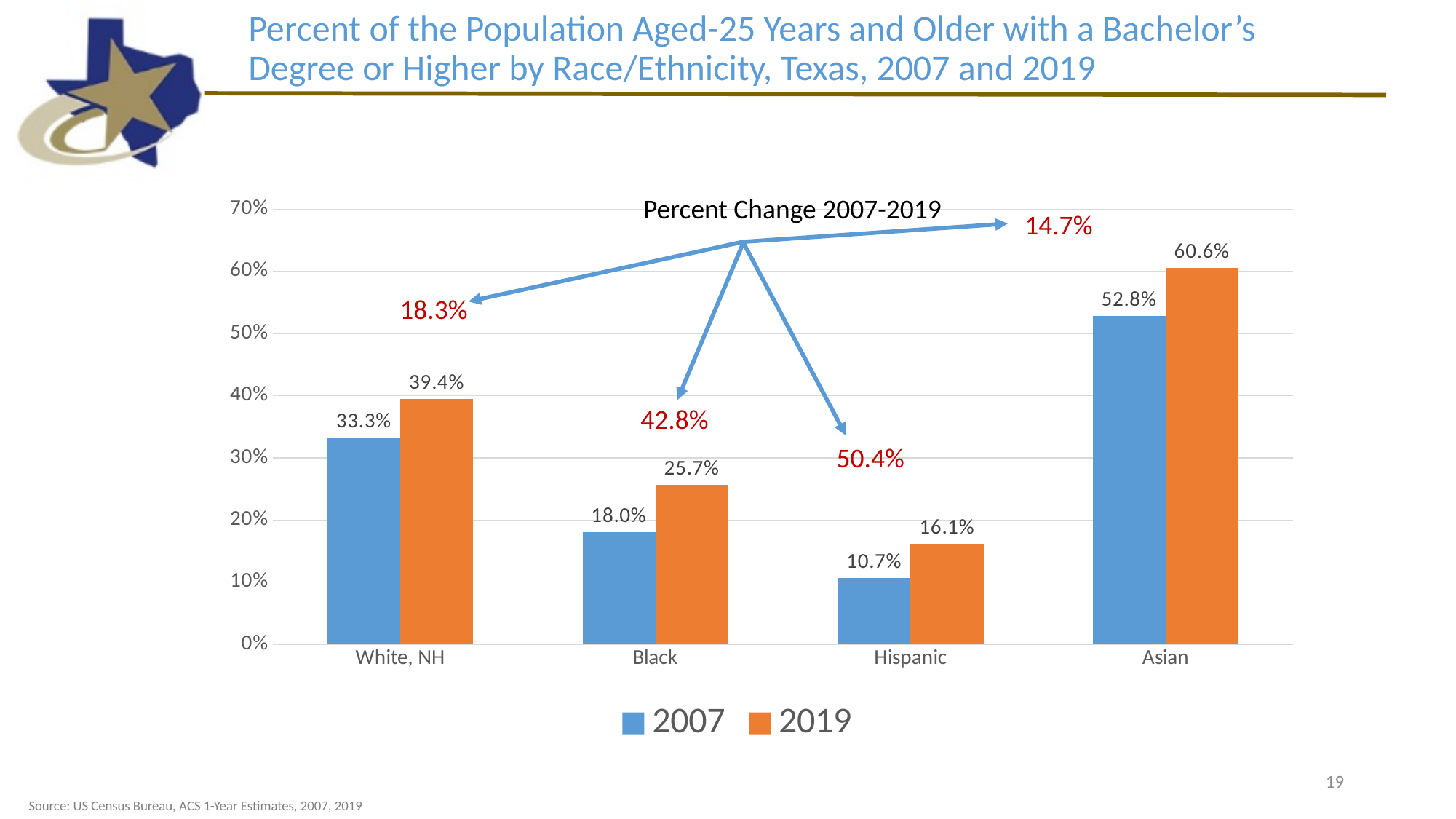
What is the 2019 value for Asian? 60.6% What is the 2019 value for Black? 25.7% What percent change from 2007 to 2019 is annotated for Hispanic? 50.4% Which category has the lowest 2019 value? Hispanic Which is larger: the 2019 value for Black or the 2007 value for White, NH? 2007 value for White, NH Which colour represents the 2019 series in the legend? Orange What is the 2007 value for Hispanic? 10.7% What kind of chart is shown on the slide? Bar chart What is the difference between the 2019 and 2007 values for White, NH? 6.1% How many race/ethnicity categories are shown on the x axis? 4 How many series does the legend list? 2 Which category has the highest 2007 value? Asian